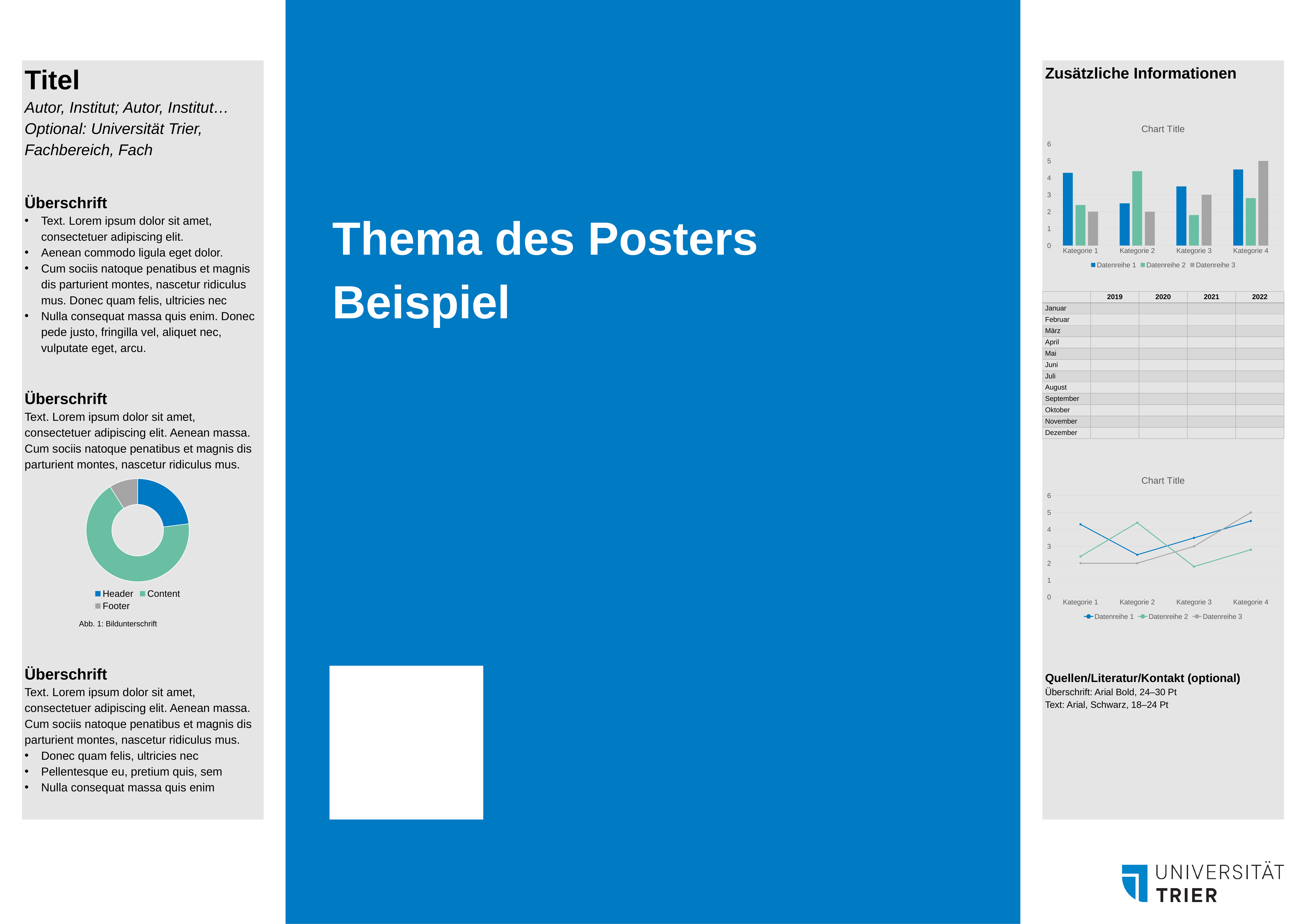
In the doughnut chart on the left of the slide, which slice is the largest? Content What kind of chart is the lower chart on the right side of the slide? line chart How many entries does the legend of the doughnut chart on the left of the slide list? 3 In the doughnut chart on the left of the slide, which slice is the smallest? Footer How many categories are shown on the x axis of the upper bar chart on the right side of the slide? 4 In the upper bar chart on the right side of the slide, is the value for Datenreihe 1 in Kategorie 1 greater or less than 4? greater In the upper bar chart on the right side of the slide, which category has the highest value for Datenreihe 3? Kategorie 4 What kind of chart is the upper chart on the right side of the slide? bar chart How many series does the legend of the upper bar chart on the right side of the slide list? 3 What kind of chart is the chart on the left of the slide captioned 'Abb. 1: Bildunterschrift'? doughnut chart In the upper bar chart on the right side of the slide, which is larger in Kategorie 2: Datenreihe 1 or Datenreihe 2? Datenreihe 2 In the upper bar chart on the right side of the slide, which category has the highest value for Datenreihe 2? Kategorie 2